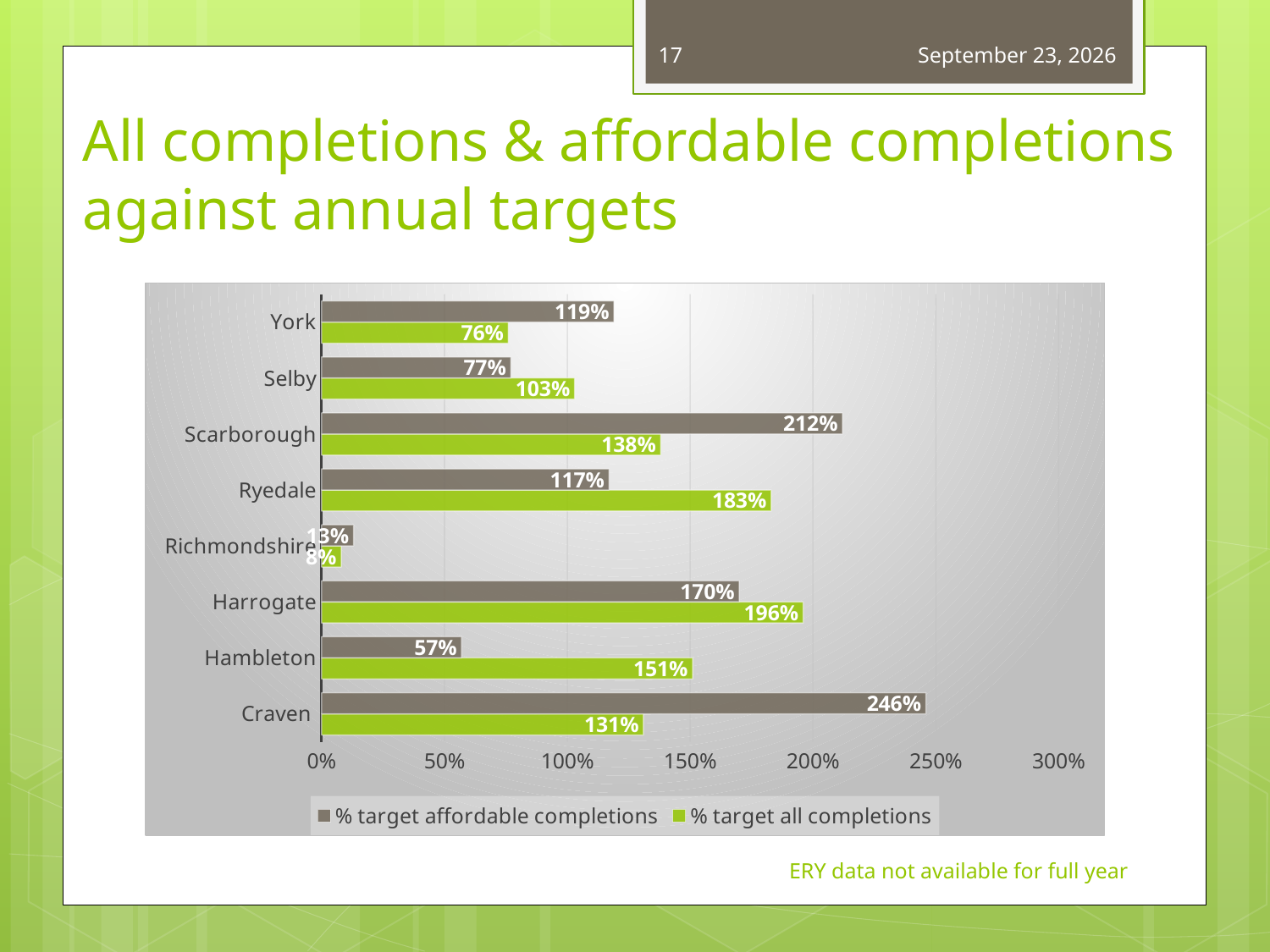
How many local authorities (categories) are shown on the chart? 8 What is the % target affordable completions value for Craven? 246% Which series is shown in green in the legend? % target all completions What is the % target all completions value for Harrogate? 196% Which local authority has the highest % target affordable completions? Craven Is the % target affordable completions value for Selby greater or less than 100%? less What type of chart is shown on the slide? bar chart What is the % target all completions value for Hambleton? 151% For Ryedale, which is larger: % target affordable completions or % target all completions? % target all completions How many series does the legend list? 2 Which local authority has the lowest % target all completions? Richmondshire What is the difference between the % target affordable completions and the % target all completions for Scarborough? 74%